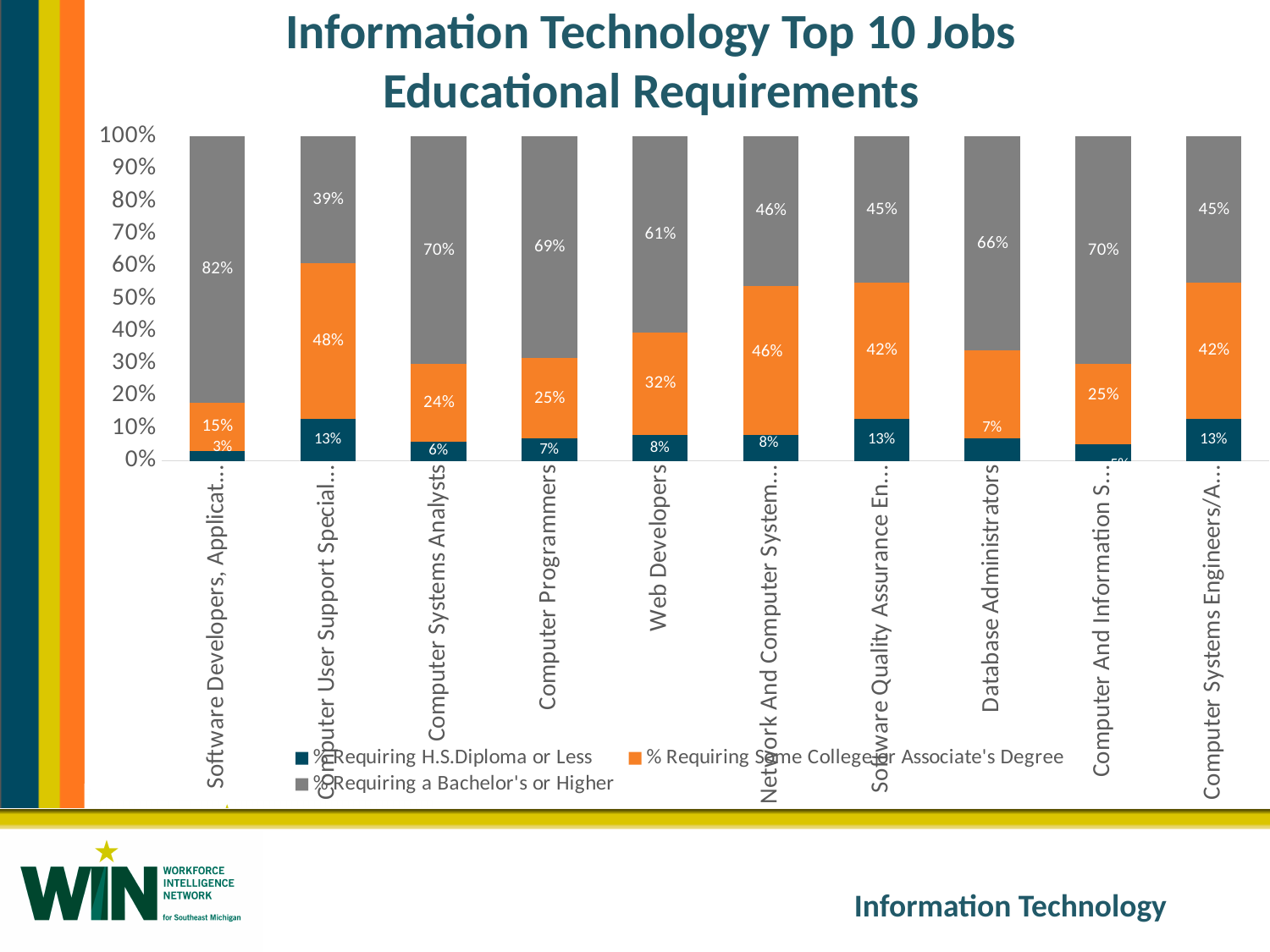
What percentage of Computer Programmers jobs require Some College or Associate's Degree? 25% Which has a larger share requiring Some College or Associate's Degree, Web Developers or Computer Programmers? Web Developers What is the difference between the Bachelor's or Higher share for Computer Systems Analysts and for Web Developers? 9 percentage points What percentage of Web Developers jobs require a Bachelor's or Higher? 61% How many job categories are plotted on the chart? 10 Which has a larger share requiring a Bachelor's or Higher, Web Developers or Computer Programmers? Computer Programmers What percentage of Computer Systems Analysts jobs require H.S. Diploma or Less? 6% Is the Bachelor's or Higher share for Database Administrators greater or less than 50%? greater What percentage of Database Administrators jobs require a Bachelor's or Higher? 66% How many series does the legend list? 3 What type of chart is shown on the slide? Stacked bar chart Which series is shown in orange in the legend? % Requiring Some College or Associate's Degree